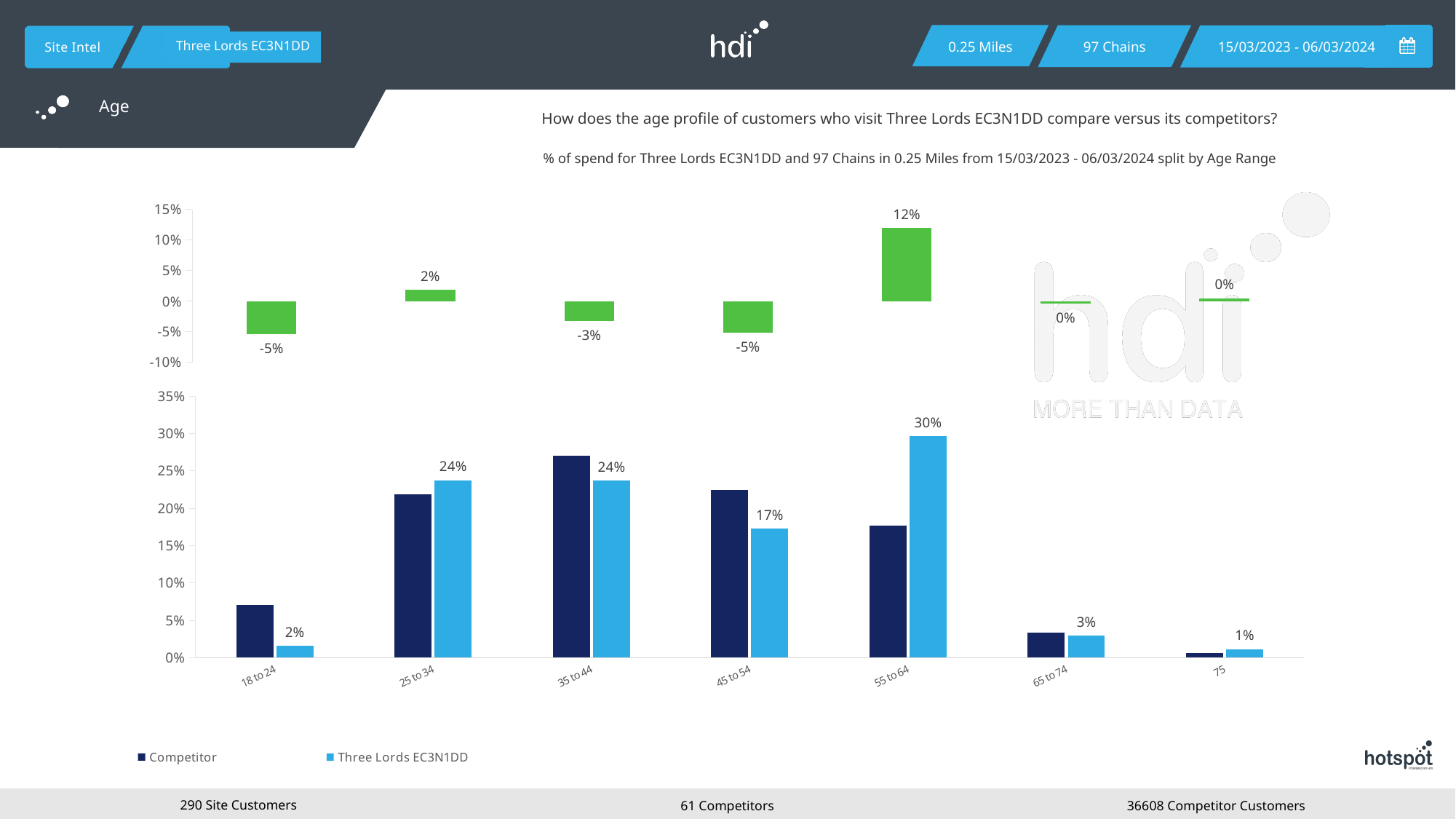
In the bottom bar chart, what is the value for Three Lords EC3N1DD in the 55 to 64 age range? 30% In the bottom bar chart, which age range has the highest value for Three Lords EC3N1DD? 55 to 64 In the top chart, what is the value shown for the 55 to 64 age range? 12% In the bottom bar chart, is the Competitor value for 35 to 44 greater or less than 25%? greater In the bottom bar chart, what is the difference between the Three Lords EC3N1DD values for 55 to 64 and 45 to 54? 13% In the top chart, which age range has the lowest value? 18 to 24 and 45 to 54 (both -5%) In the bottom bar chart, for the 35 to 44 age range, which series has the larger value: Competitor or Three Lords EC3N1DD? Competitor How many age range categories are shown on the x axis of the bottom bar chart? 7 In the bottom bar chart, is the Competitor value for 18 to 24 greater or less than 10%? less In the bottom bar chart, what is the value for Three Lords EC3N1DD in the 18 to 24 age range? 2% In the bottom bar chart, which age range has the lowest value for Three Lords EC3N1DD? 75 How many series does the legend of the bottom bar chart list? 2